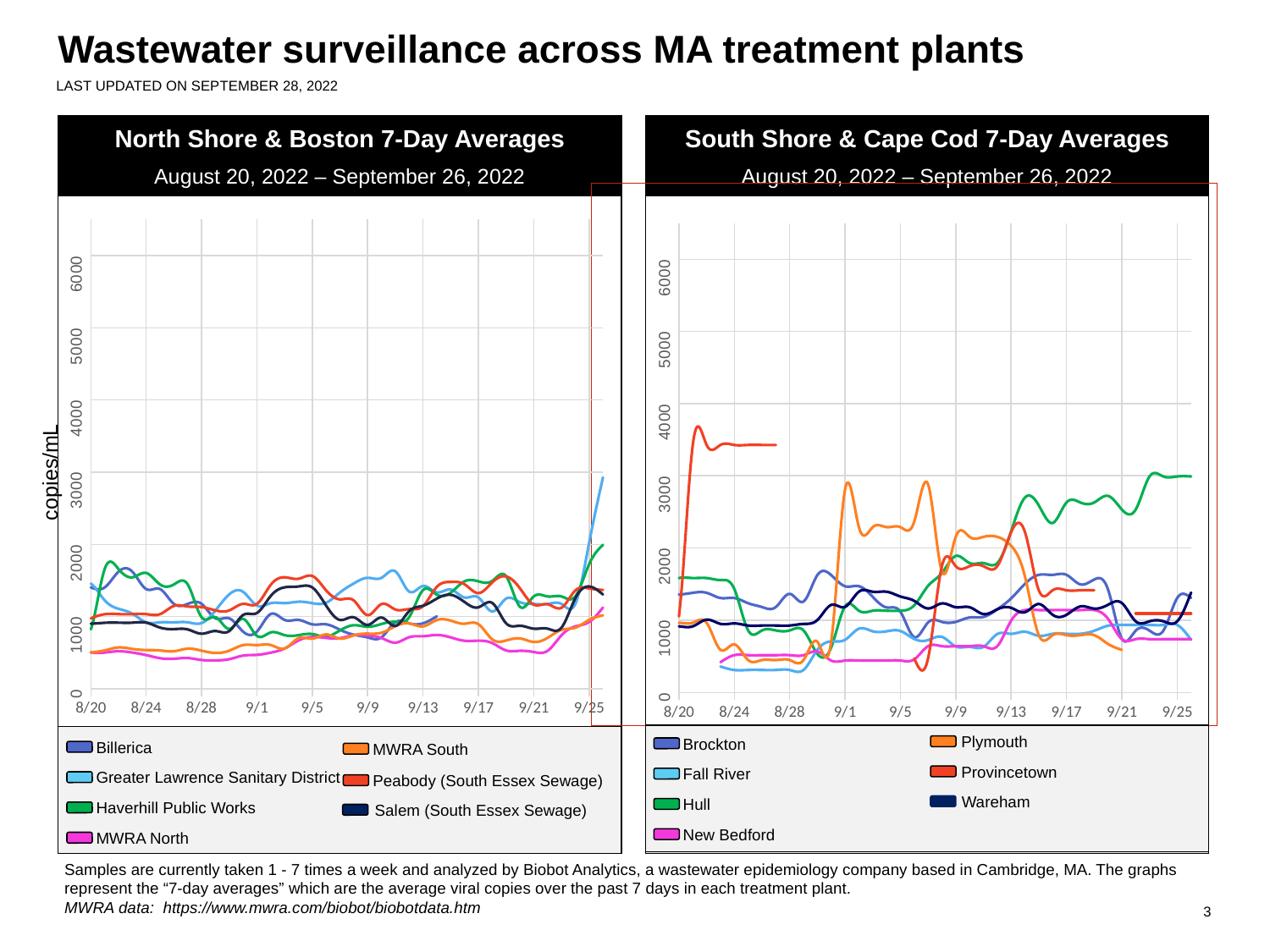
In the North Shore & Boston 7-Day Averages chart, is the value for MWRA North on 8/28 greater or less than 1000? less In the South Shore & Cape Cod 7-Day Averages chart, is the value for Fall River on 8/24 greater or less than 1000? less What is the y-axis label shared by the two charts? copies/mL In the North Shore & Boston 7-Day Averages chart, does the Greater Lawrence Sanitary District line rise or fall between 9/21 and 9/25? rise In the South Shore & Cape Cod 7-Day Averages chart, does the Hull line rise or fall overall between 9/13 and 9/25? rise In the South Shore & Cape Cod 7-Day Averages chart, is the value for Provincetown on 8/24 greater or less than 3000? greater What kind of chart is the North Shore & Boston 7-Day Averages chart? line chart How many series does the legend of the South Shore & Cape Cod 7-Day Averages chart list? 7 How many series does the legend of the North Shore & Boston 7-Day Averages chart list? 7 What date range is shown in the subtitle of the South Shore & Cape Cod 7-Day Averages chart? August 20, 2022 – September 26, 2022